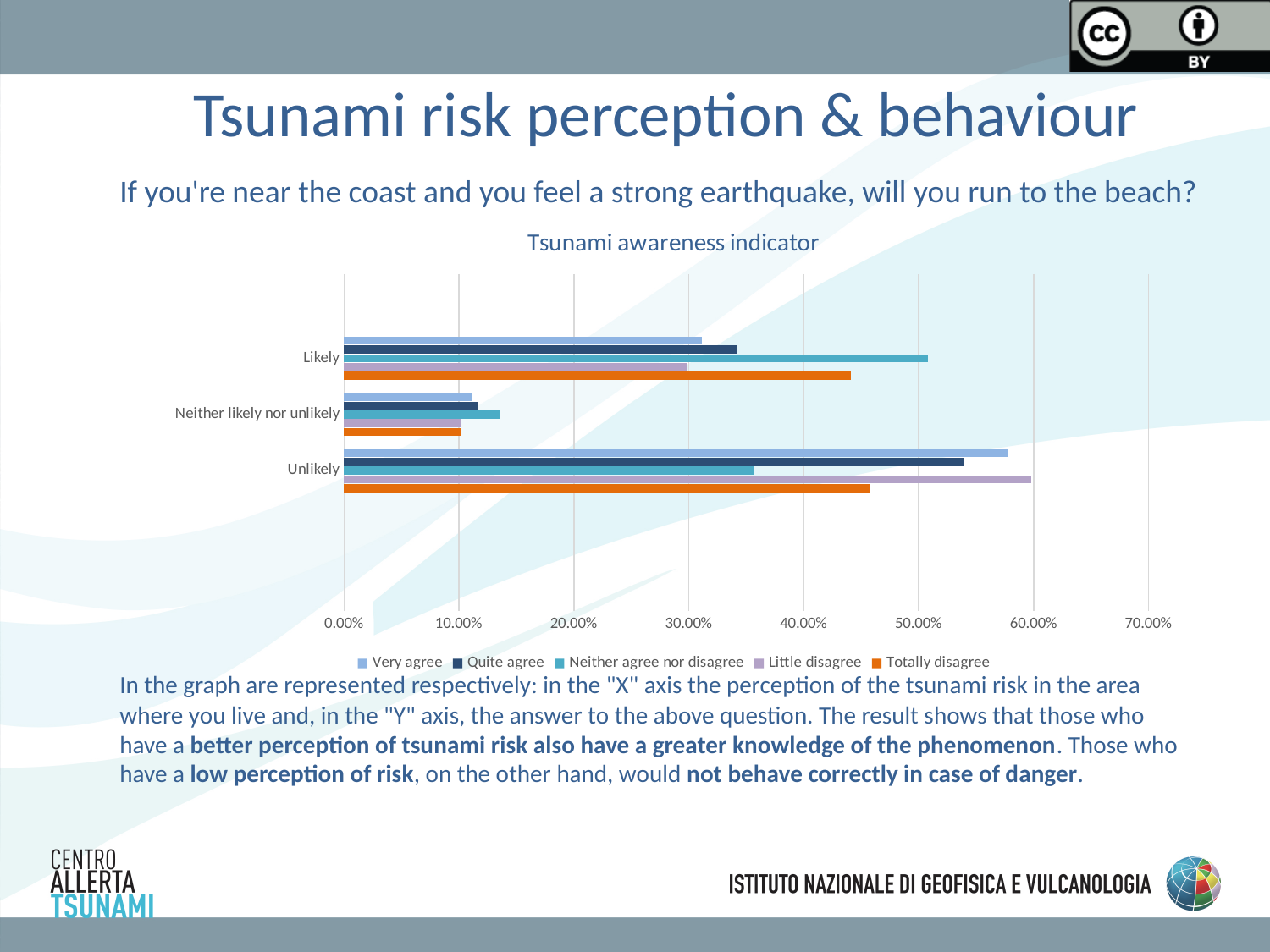
How many categories are shown on the vertical axis of the chart? 3 Which series is listed last in the chart legend? Totally disagree For the Very agree series, which category has the highest value? Unlikely Is the value for Very agree in the Neither likely nor unlikely category greater or less than 20.00%? less How many series does the chart legend list? 5 For the Neither agree nor disagree series, which is larger: the value for Likely or the value for Unlikely? Likely Is the value for Totally disagree in the Likely category greater or less than 40.00%? greater For the Very agree series, which category has the lowest value? Neither likely nor unlikely What is the title of the chart? Tsunami awareness indicator Is the value for Very agree in the Unlikely category greater or less than 50.00%? greater What type of chart is shown on the slide? Bar chart